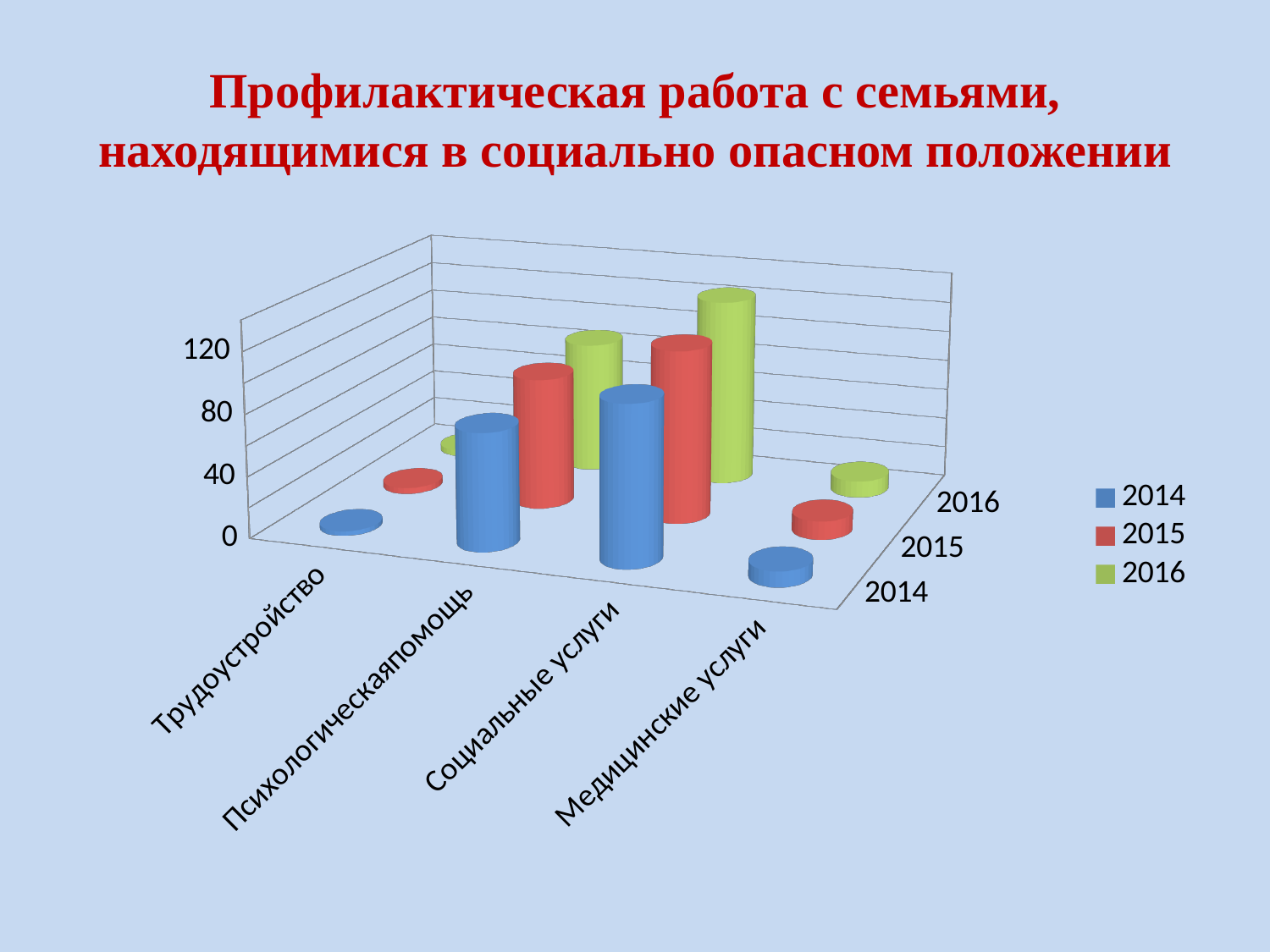
Which series has the highest value for Социальные услуги? 2016 How many categories are shown on the chart's category axis? 4 Which category has the larger 2016 value: Трудоустройство or Социальные услуги? Социальные услуги Is the 2016 value for Социальные услуги greater or less than 80? greater Is the 2015 value for Медицинские услуги greater or less than 40? less Which category has the tallest bar on the chart? Социальные услуги How many series does the legend list? 3 What kind of chart is shown on the slide? bar chart Is the 2014 value for Трудоустройство greater or less than 40? less Which colour represents the 2015 series in the legend? red Which is larger for Психологическая помощь: the 2014 value or the 2016 value? 2016 Do the values for Социальные услуги rise or fall from 2014 to 2016? rise